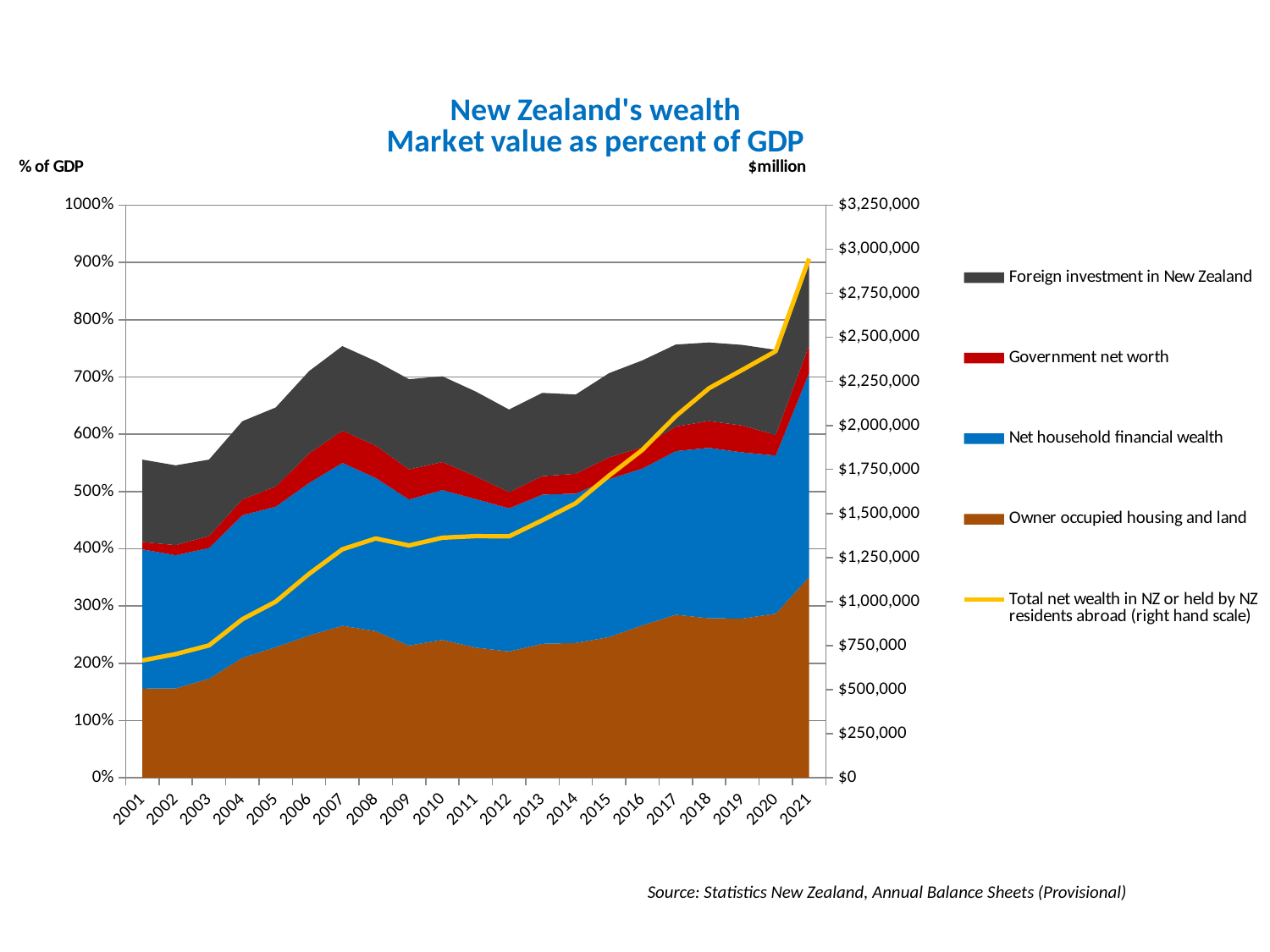
Is the top of the stacked areas in 2007 greater or less than 700% of GDP? greater How many years are shown along the x axis? 21 In which year does the total of the stacked areas reach its highest level? 2021 Is the Total net wealth in NZ or held by NZ residents abroad in 2021 greater or less than $2,750,000? greater Does the Total net wealth in NZ or held by NZ residents abroad line rise or fall overall from 2001 to 2021? rise What kind of chart is shown on the slide? stacked area chart with a line Which series is plotted on the right hand scale? Total net wealth in NZ or held by NZ residents abroad How many series does the legend list? 5 What is the title of the chart? New Zealand's wealth Market value as percent of GDP Is the value for Owner occupied housing and land in 2001 greater or less than 200%? less